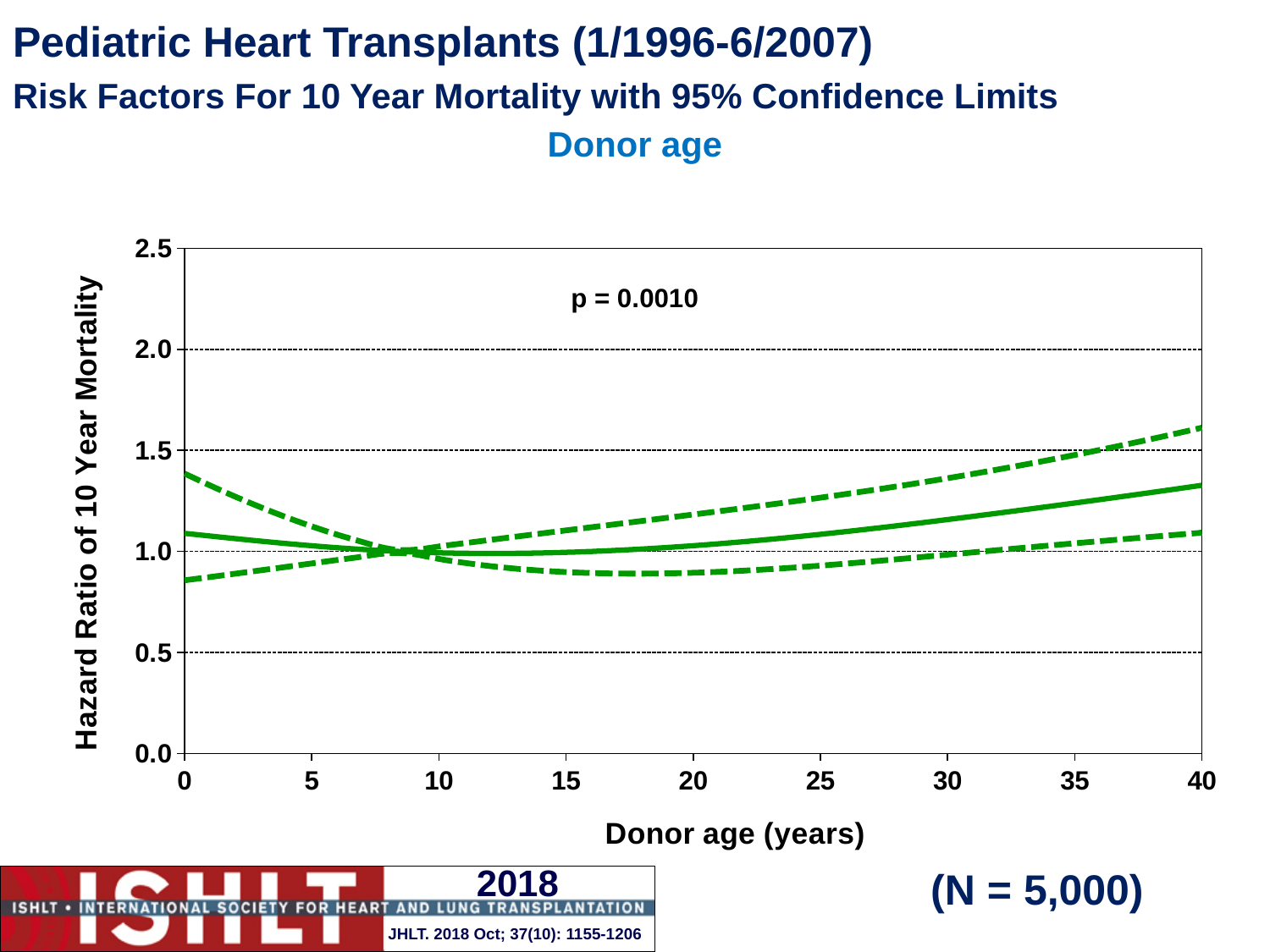
How many lines are plotted on the chart? 3 Is the hazard ratio (solid line) at donor age 0 greater or less than 1.5? less What is the highest value shown on the y axis of the chart? 2.5 Is the lower 95% confidence limit (lower dashed line) at donor age 20 greater or less than 1.0? less Does the hazard ratio (solid line) rise or fall as donor age increases from 20 to 40 years? rise Does the upper 95% confidence limit (upper dashed line) rise or fall as donor age increases from 0 to 5 years? fall What kind of chart is shown on the slide? line chart Is the upper 95% confidence limit (upper dashed line) at donor age 40 greater or less than 1.5? greater What p-value is printed on the chart? p = 0.0010